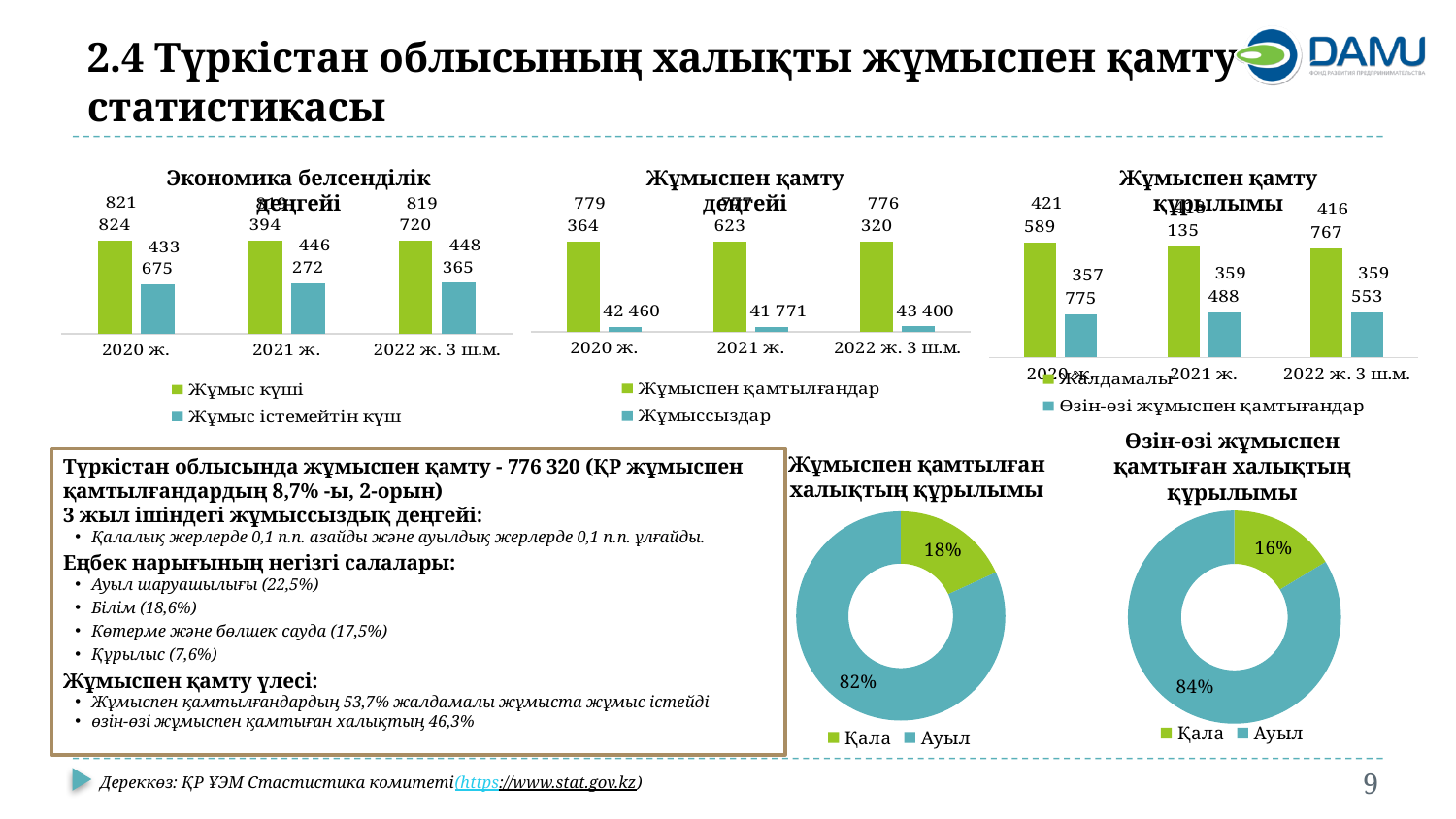
How many series does the legend of the chart titled 'Жұмыспен қамту құрылымы' list? 2 In the chart titled 'Жұмыспен қамту деңгейі', by how much does 'Жұмыссыздар' in 2022 ж. 3 ш.м. exceed 'Жұмыссыздар' in 2020 ж.? 940 In the chart titled 'Жұмыспен қамту деңгейі', what is the value of 'Жұмыспен қамтылғандар' for 2022 ж. 3 ш.м.? 776 320 In the chart titled 'Жұмыспен қамту деңгейі', in which period is 'Жұмыссыздар' highest? 2022 ж. 3 ш.м. In the chart titled 'Жұмыспен қамту деңгейі', what is the value of 'Жұмыссыздар' for 2021 ж.? 41 771 In the pie chart titled 'Өзін-өзі жұмыспен қамтыған халықтың құрылымы', what share does 'Қала' have? 16% In the pie chart titled 'Жұмыспен қамтылған халықтың құрылымы', what share does 'Ауыл' have? 82% In the chart titled 'Жұмыспен қамту құрылымы', what is the value of 'Өзін-өзі жұмыспен қамтығандар' for 2022 ж. 3 ш.м.? 359 553 In the chart titled 'Экономика белсенділік деңгейі', what is the value of 'Жұмыс күші' for 2020 ж.? 821 824 What type of chart is the one titled 'Экономика белсенділік деңгейі'? bar chart How many periods are shown on the x axis of the chart titled 'Жұмыспен қамту деңгейі'? 3 In the chart titled 'Экономика белсенділік деңгейі', what is the difference between 'Жұмыс күші' and 'Жұмыс істемейтін күш' for 2022 ж. 3 ш.м.? 371 355